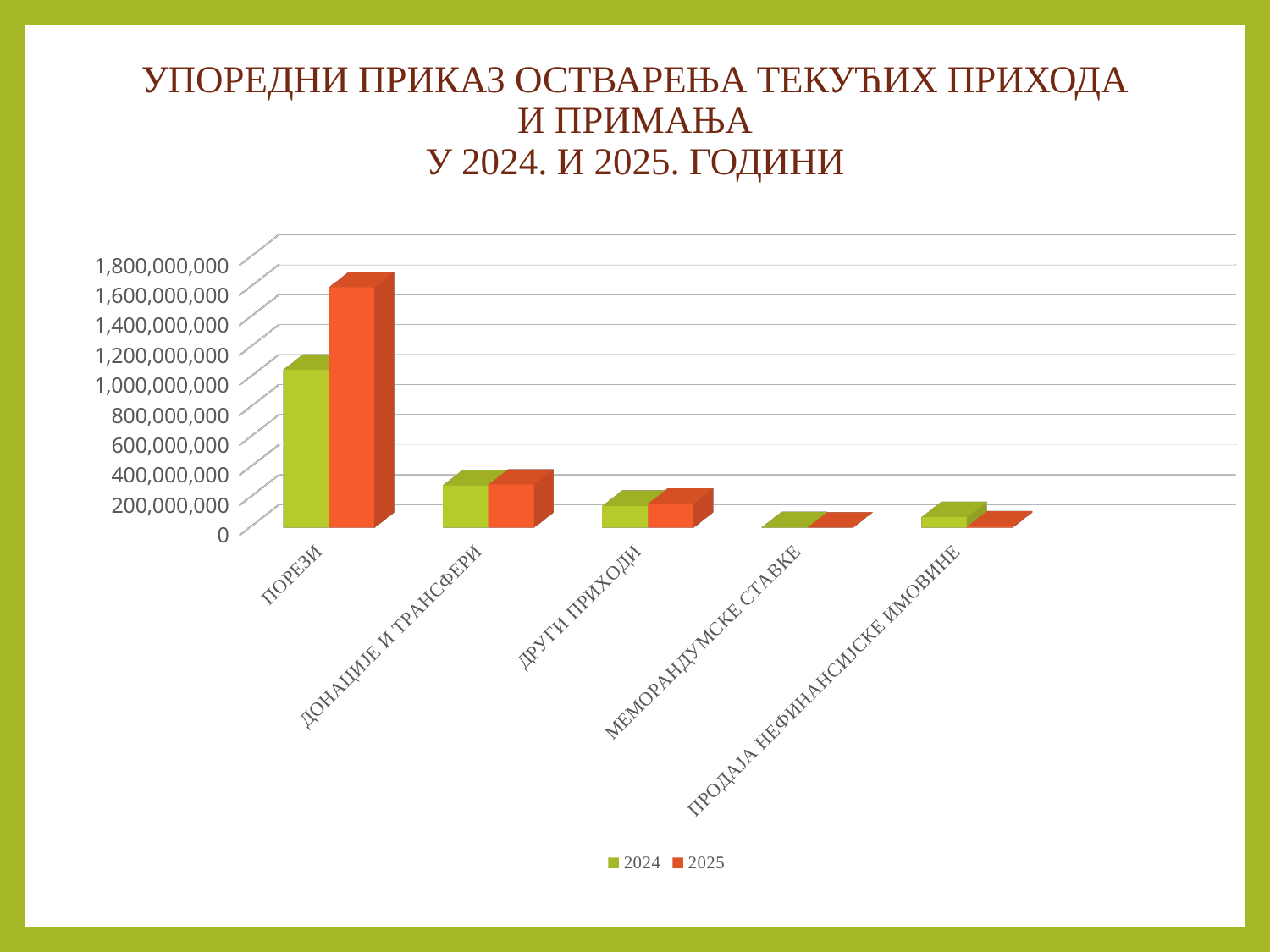
Which colour represents the 2025 series in the legend? orange Which category has the lowest value for 2024? МЕМОРАНДУМСКЕ СТАВКЕ Is the 2025 value for ПОРЕЗИ greater or less than 1,400,000,000? greater Which category has the highest value for 2025? ПОРЕЗИ For ПОРЕЗИ, which year has the larger value, 2024 or 2025? 2025 Is the 2024 value for ПОРЕЗИ greater or less than 800,000,000? greater For 2024, which is larger: ПОРЕЗИ or ДОНАЦИЈЕ И ТРАНСФЕРИ? ПОРЕЗИ Is the 2024 value for ДОНАЦИЈЕ И ТРАНСФЕРИ greater or less than 400,000,000? less How many series does the legend list? 2 How many categories are shown on the x axis? 5 What kind of chart is shown on the slide? bar chart